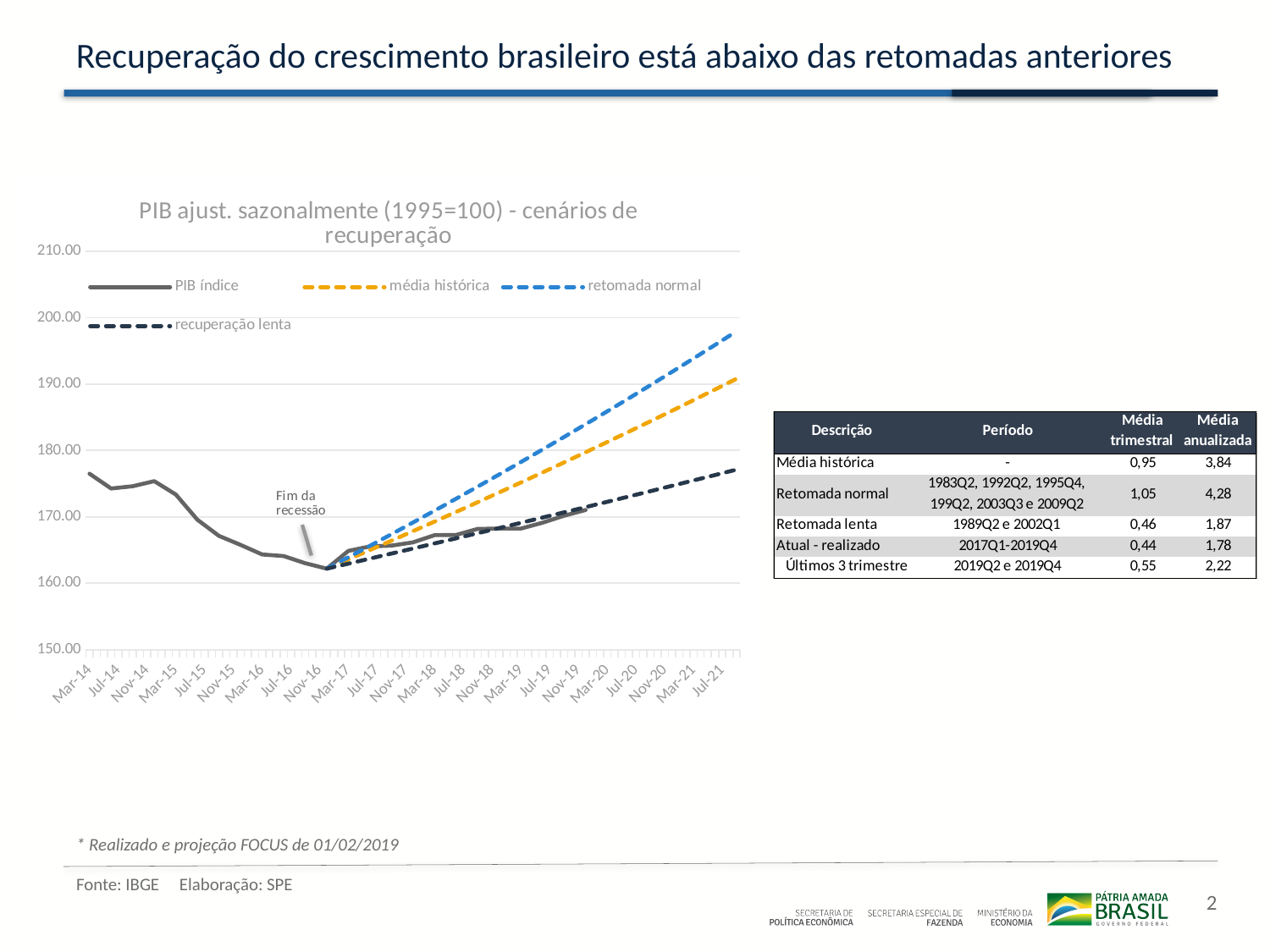
Does the PIB índice line rise or fall between Mar-14 and Nov-16? fall What does the annotation with the arrow pointing to the low point of the PIB índice line say? Fim da recessão Is the value of PIB índice at its lowest point (around Nov-16) greater or less than 170? less Is the value of the média histórica line at Jul-21 greater or less than 180? greater Is the value of the recuperação lenta line at Jul-21 greater or less than 180? less What is the title of the chart? PIB ajust. sazonalmente (1995=100) - cenários de recuperação How many series does the chart legend list? 4 Which series reaches the highest value at the right end of the chart (Jul-21)? retomada normal At Jul-21, which line is higher: retomada normal or recuperação lenta? retomada normal What kind of chart is shown on the slide? line chart